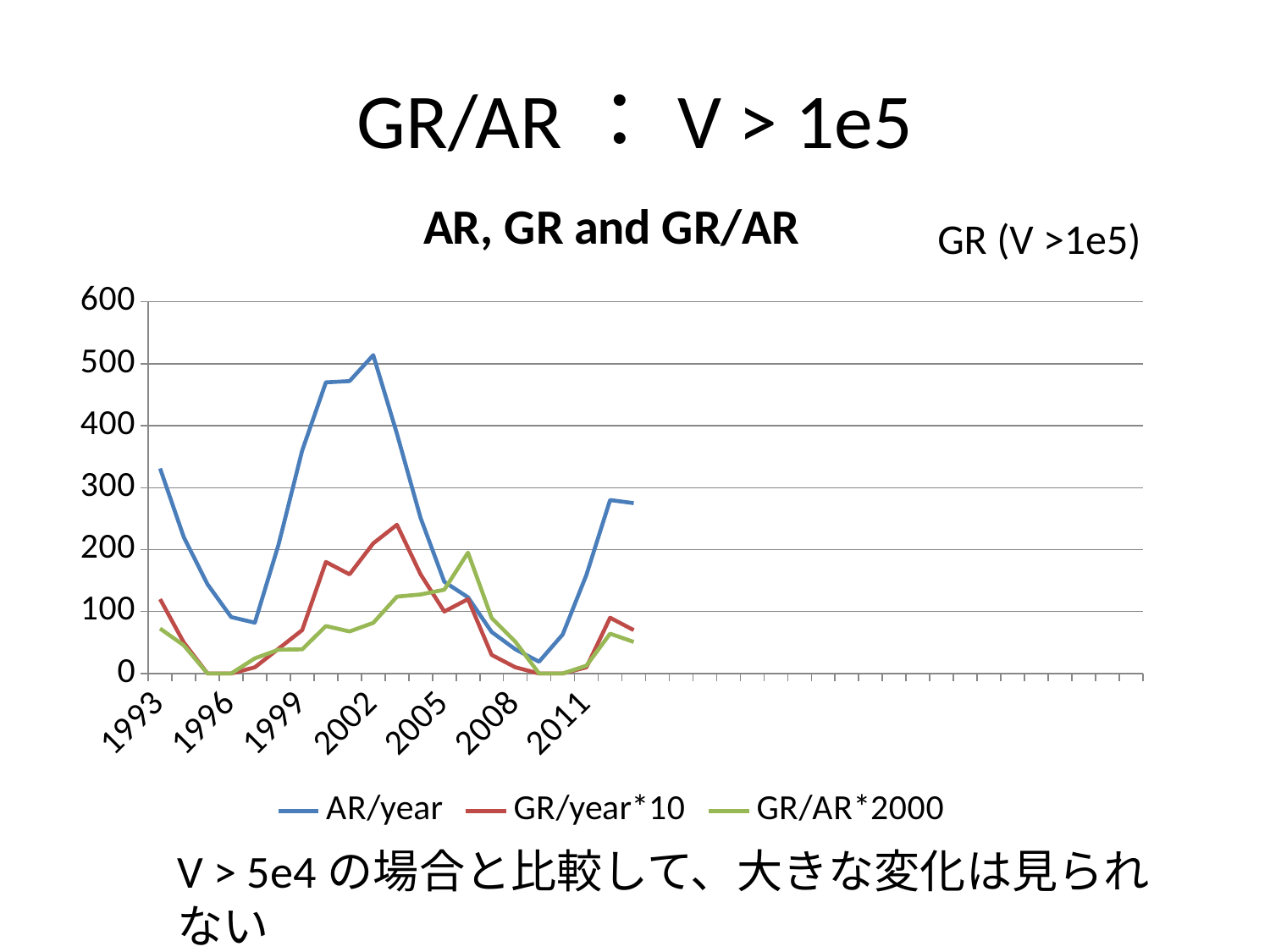
Is the value of AR/year in 2011 greater or less than 100? greater Which series has the highest value in 2002? AR/year Does the AR/year series rise or fall between 1999 and 2002? rise How many series does the legend list? 3 What kind of chart is shown on the slide? line chart Is the value of AR/year in 2002 greater or less than 400? greater Which series is drawn in blue? AR/year What is the title of the chart? AR, GR and GR/AR Is the value of AR/year in 1993 greater or less than 300? greater Which series has the lowest value in 2002? GR/AR*2000